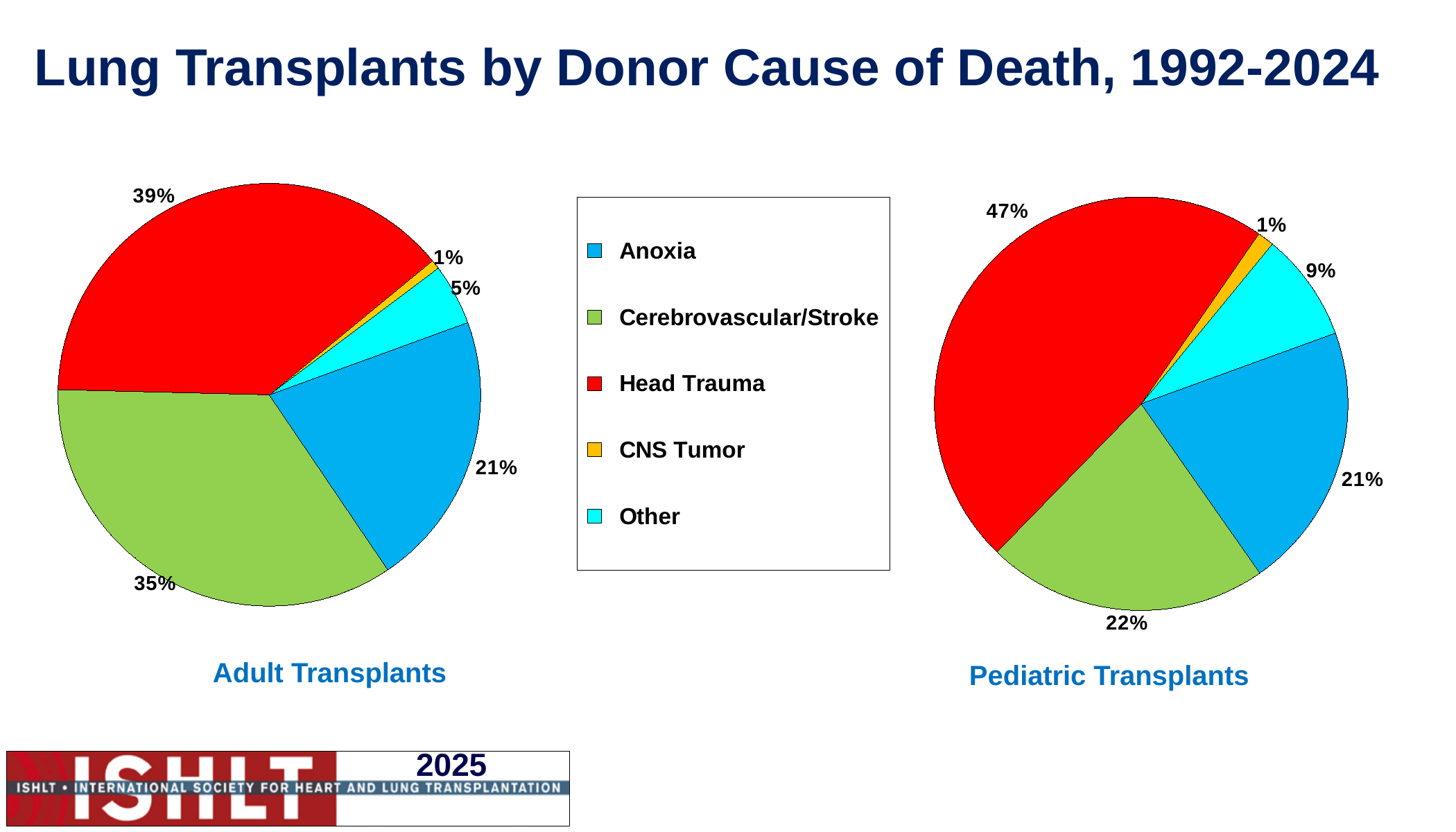
In the Pediatric Transplants pie chart, which cause of death has the largest share? Head Trauma In the Pediatric Transplants pie chart, what share of donors died of Cerebrovascular/Stroke? 22% In the Pediatric Transplants pie chart, what percentage is shown for Other? 9% What type of chart is used for the Adult Transplants data? Pie chart Which chart shows a larger share for Head Trauma, Adult Transplants or Pediatric Transplants? Pediatric Transplants In the Adult Transplants pie chart, which is larger, the Other share or the Anoxia share? Anoxia In the Adult Transplants pie chart, which cause of death has the smallest share? CNS Tumor In the Pediatric Transplants pie chart, what is the difference between the Head Trauma share and the Anoxia share? 26% In the Adult Transplants pie chart, what is the difference between the Head Trauma share and the Cerebrovascular/Stroke share? 4% How many categories does the legend list? 5 In the Adult Transplants pie chart, what percentage is shown for Anoxia? 21% In the Adult Transplants pie chart, what share of donors died of Head Trauma? 39%